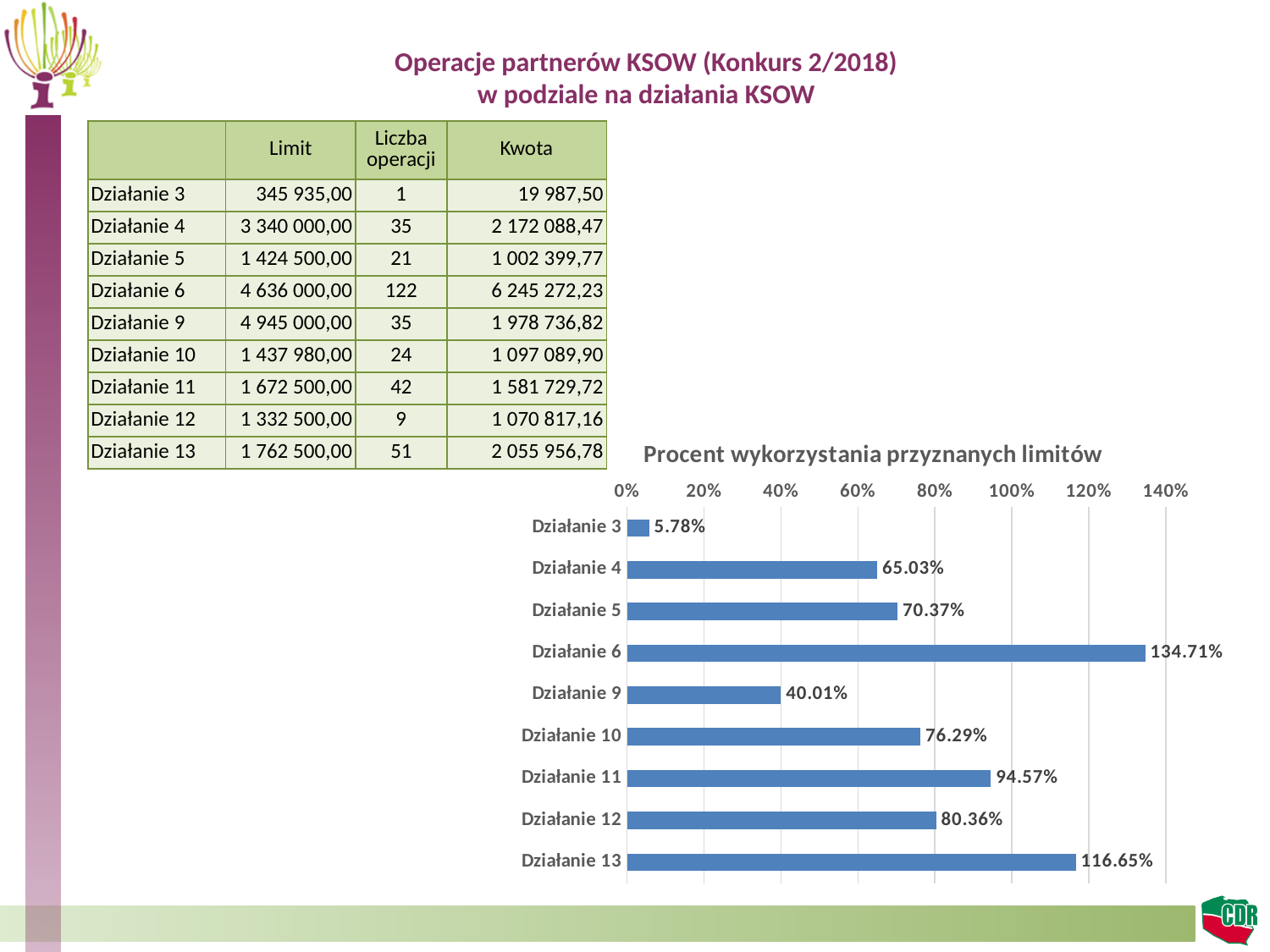
Is the value for Działanie 11 greater or less than 100%? less What is the difference between the values for Działanie 11 and Działanie 10? 18.28% What is the difference between the values for Działanie 13 and Działanie 12? 36.29% Which category has the highest value in the chart? Działanie 6 What is the value for Działanie 12 in the chart? 80.36% What is the value for Działanie 6 in the chart? 134.71% How many categories are shown in the chart? 9 What is the title of the chart? Procent wykorzystania przyznanych limitów What kind of chart is shown on the slide? bar chart Which is larger, the value for Działanie 4 or the value for Działanie 5? Działanie 5 Which category has the lowest value in the chart? Działanie 3 What is the value for Działanie 9 in the chart? 40.01%